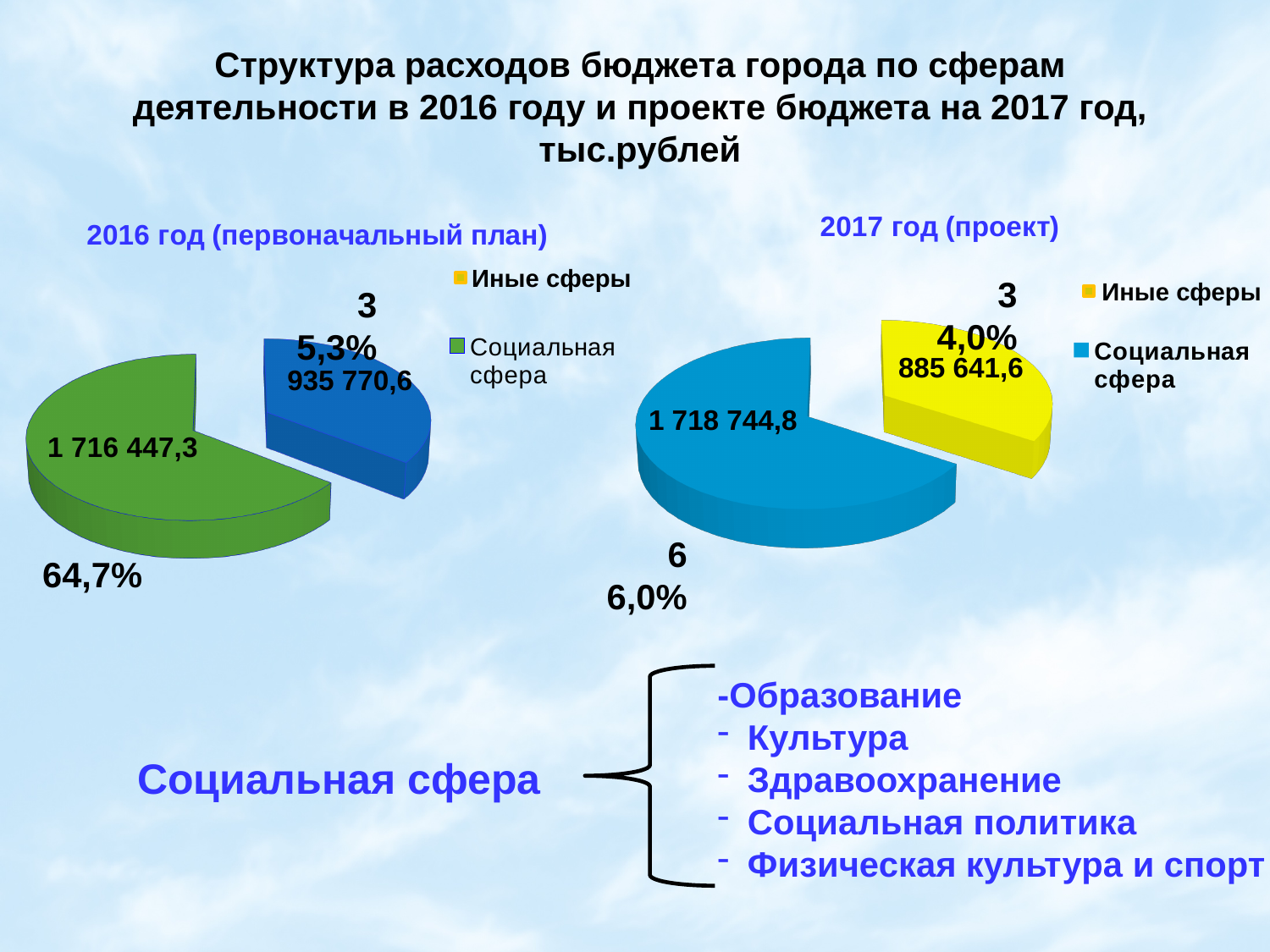
In the 2016 год (первоначальный план) chart, what is the value for Социальная сфера? 1 716 447,3 In the 2016 год (первоначальный план) chart, what share of the pie does Социальная сфера represent? 64,7% In the 2016 год (первоначальный план) chart, which category has the smallest slice? Иные сферы Which is larger: Иные сферы in the 2016 год (первоначальный план) chart or Иные сферы in the 2017 год (проект) chart? 2016 год (первоначальный план) In the 2017 год (проект) chart, which category has the largest slice? Социальная сфера In the 2016 год (первоначальный план) chart, what is the difference between Социальная сфера and Иные сферы? 780 676,7 In the 2017 год (проект) chart, what colour is the Иные сферы slice? Yellow What type of chart is the 2016 год (первоначальный план) chart? Pie chart How many slices does the 2017 год (проект) chart have? 2 In the 2017 год (проект) chart, what is the value for Социальная сфера? 1 718 744,8 In the 2016 год (первоначальный план) chart, what is the value for Иные сферы? 935 770,6 In the 2017 год (проект) chart, what is the value for Иные сферы? 885 641,6